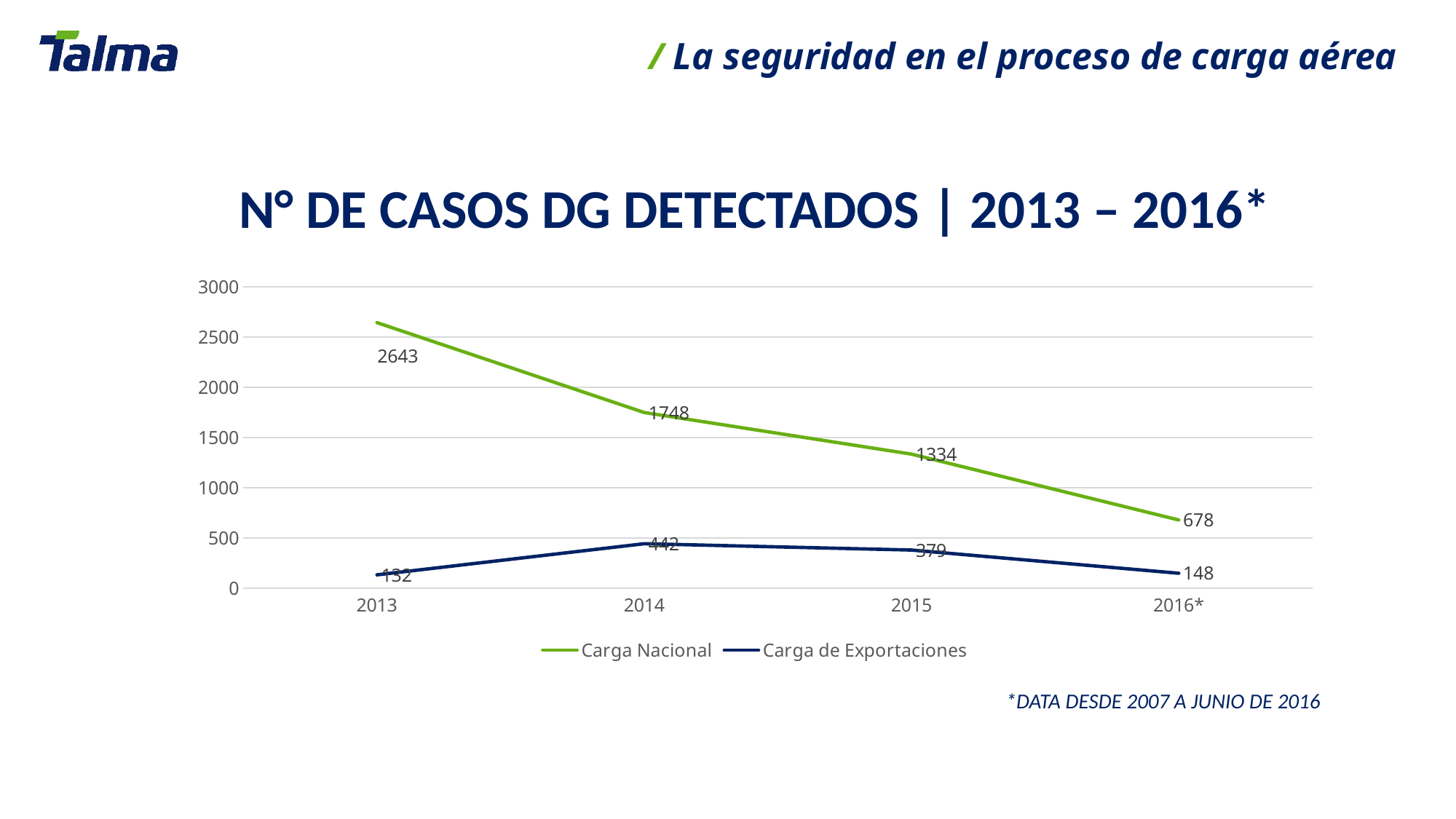
Which is larger in 2015: Carga Nacional or Carga de Exportaciones? Carga Nacional In which year is Carga de Exportaciones lowest? 2013 In which year is Carga Nacional highest? 2013 What type of chart is shown on the slide? Line chart What is the value for Carga Nacional in 2016*? 678 What is the difference between Carga Nacional in 2014 and in 2015? 414 What is the value for Carga Nacional in 2013? 2643 How many years are shown on the x axis? 4 Does Carga Nacional rise or fall from 2013 to 2016*? Fall What is the value for Carga de Exportaciones in 2014? 442 What is the value for Carga de Exportaciones in 2015? 379 How many series does the legend list? 2